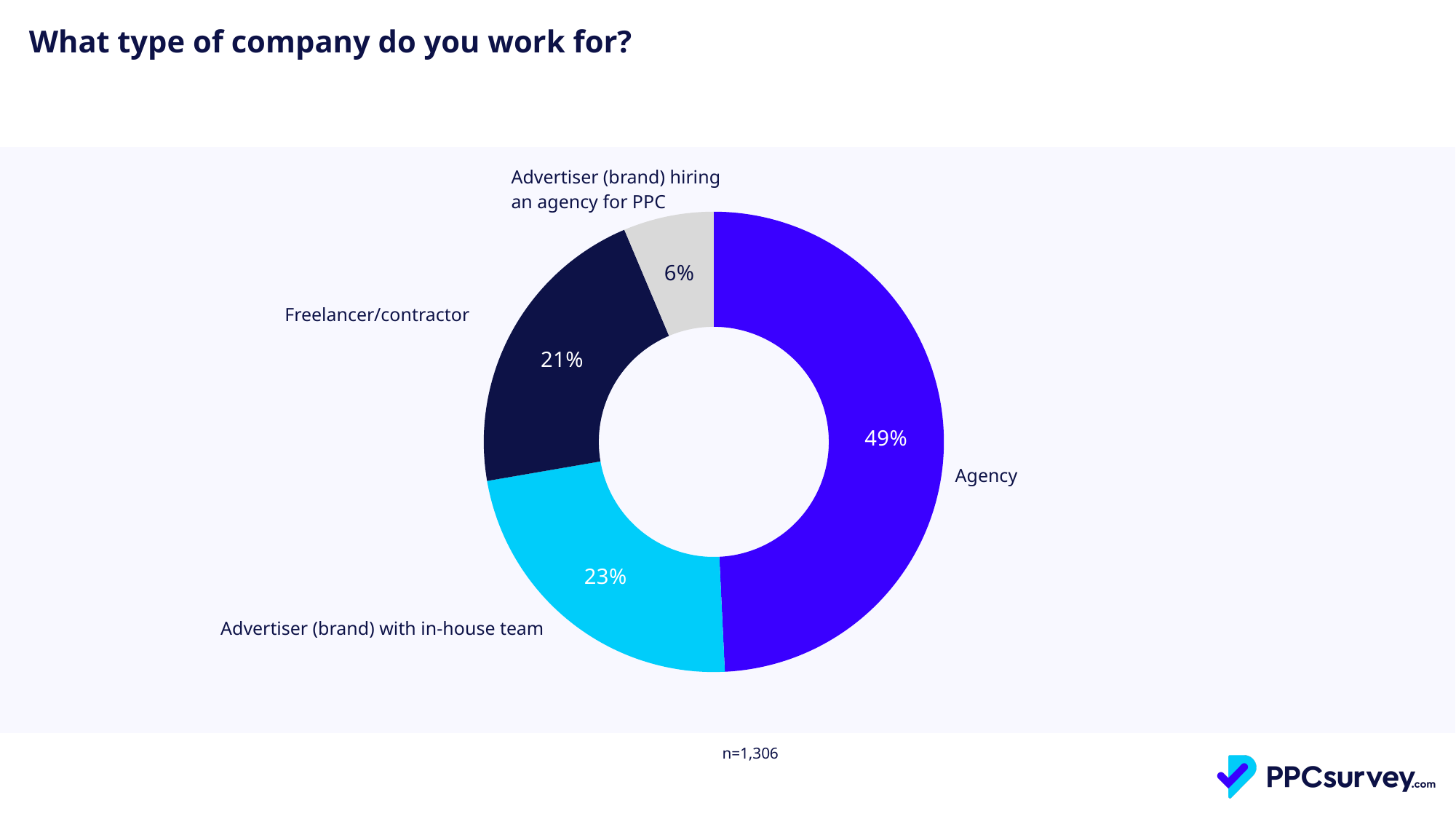
How many company types are shown in the chart? 4 Which is larger: the share for Advertiser (brand) with in-house team or for Freelancer/contractor? Advertiser (brand) with in-house team What is the sample size (n) shown on the slide? n=1,306 What percentage of respondents are Freelancer/contractor? 21% What percentage of respondents work for an Advertiser (brand) with in-house team? 23% What kind of chart is shown on the slide? Pie chart (donut) What is the difference in percentage points between Agency and Freelancer/contractor? 28 What percentage of respondents work for an Advertiser (brand) hiring an agency for PPC? 6% Which company type has the largest share of respondents? Agency Which company type has the smallest share of respondents? Advertiser (brand) hiring an agency for PPC What percentage of respondents work for an Agency? 49% What is the difference in percentage points between Advertiser (brand) with in-house team and Advertiser (brand) hiring an agency for PPC? 17